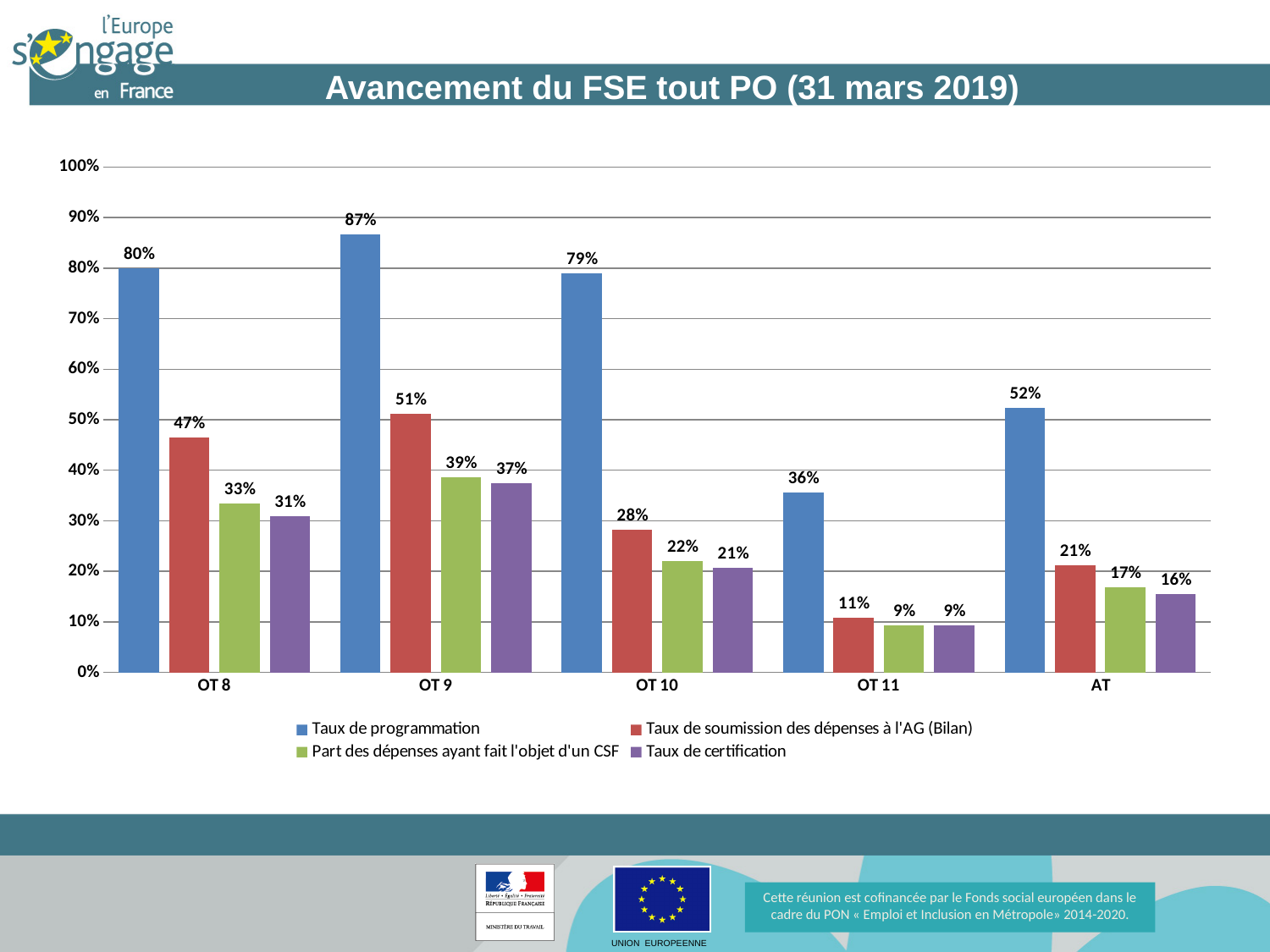
Which is larger: the Taux de soumission des dépenses à l'AG (Bilan) for OT 9 or for OT 10? OT 9 What is the Taux de certification for OT 10? 21% What is the Taux de programmation for OT 9? 87% Which category has the lowest Part des dépenses ayant fait l'objet d'un CSF? OT 11 What is the Taux de soumission des dépenses à l'AG (Bilan) for AT? 21% What is the difference between the Taux de programmation and the Taux de certification for OT 8? 49% What is the title of the slide? Avancement du FSE tout PO (31 mars 2019) What kind of chart is shown on the slide? Bar chart How many series does the legend list? 4 What is the difference between the Taux de programmation for OT 11 and for AT? 16% How many categories are shown on the x axis? 5 Which category has the highest Taux de programmation? OT 9